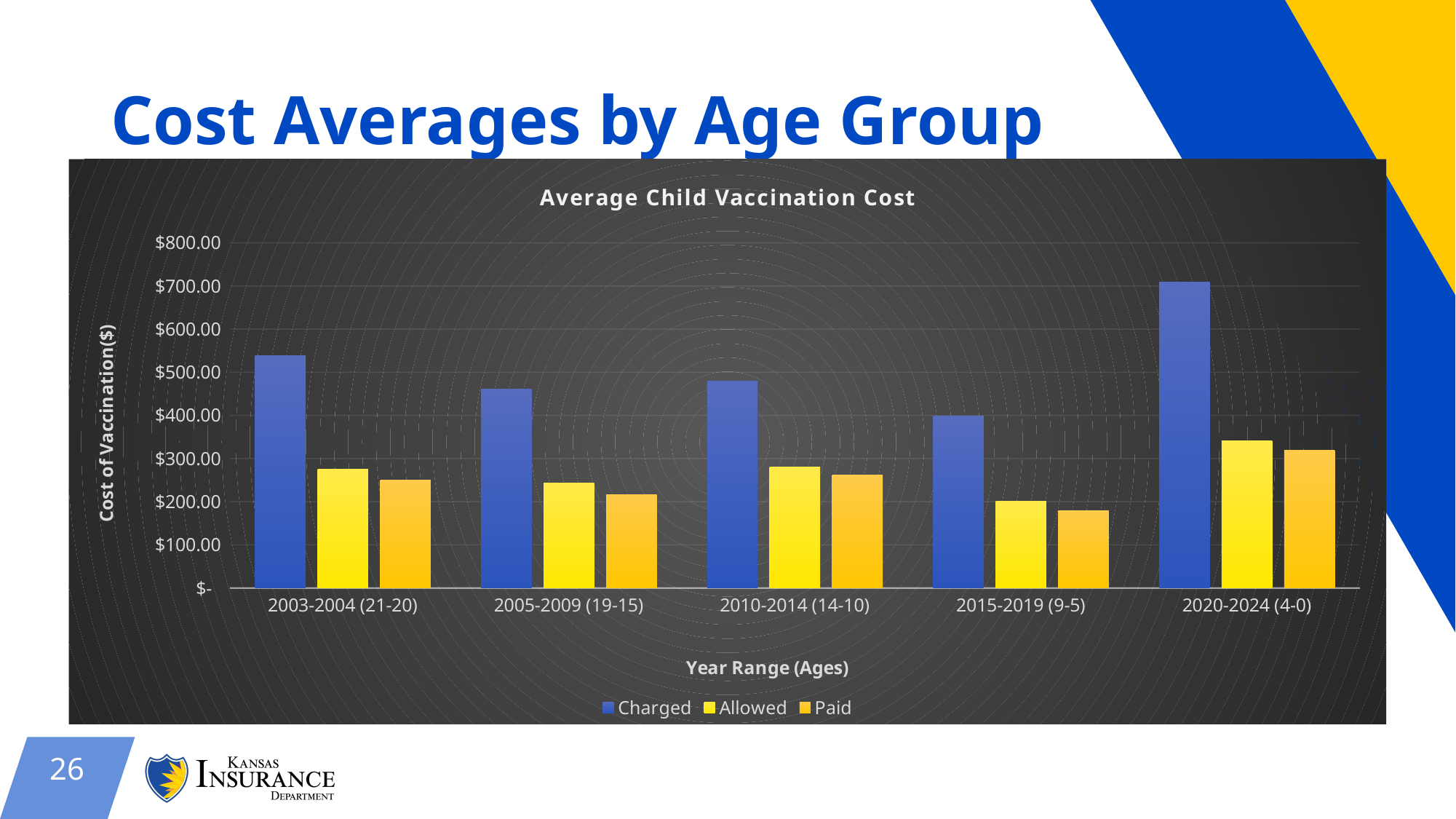
How many series does the legend list? 3 Which year range has the lowest Charged value? 2015-2019 (9-5) Which year range has the highest Charged value? 2020-2024 (4-0) Which year range has the lowest Paid value? 2015-2019 (9-5) How many year-range categories are shown on the x axis? 5 Is the Paid value for 2015-2019 (9-5) greater or less than $200.00? less Is the Charged value for 2020-2024 (4-0) greater or less than $600.00? greater What is the title of the chart? Average Child Vaccination Cost What kind of chart is shown on the slide? bar chart Which is larger, the Charged value for 2003-2004 (21-20) or the Charged value for 2010-2014 (14-10)? 2003-2004 (21-20) Which year range has the highest Allowed value? 2020-2024 (4-0) Is the Charged value for 2003-2004 (21-20) greater or less than $500.00? greater